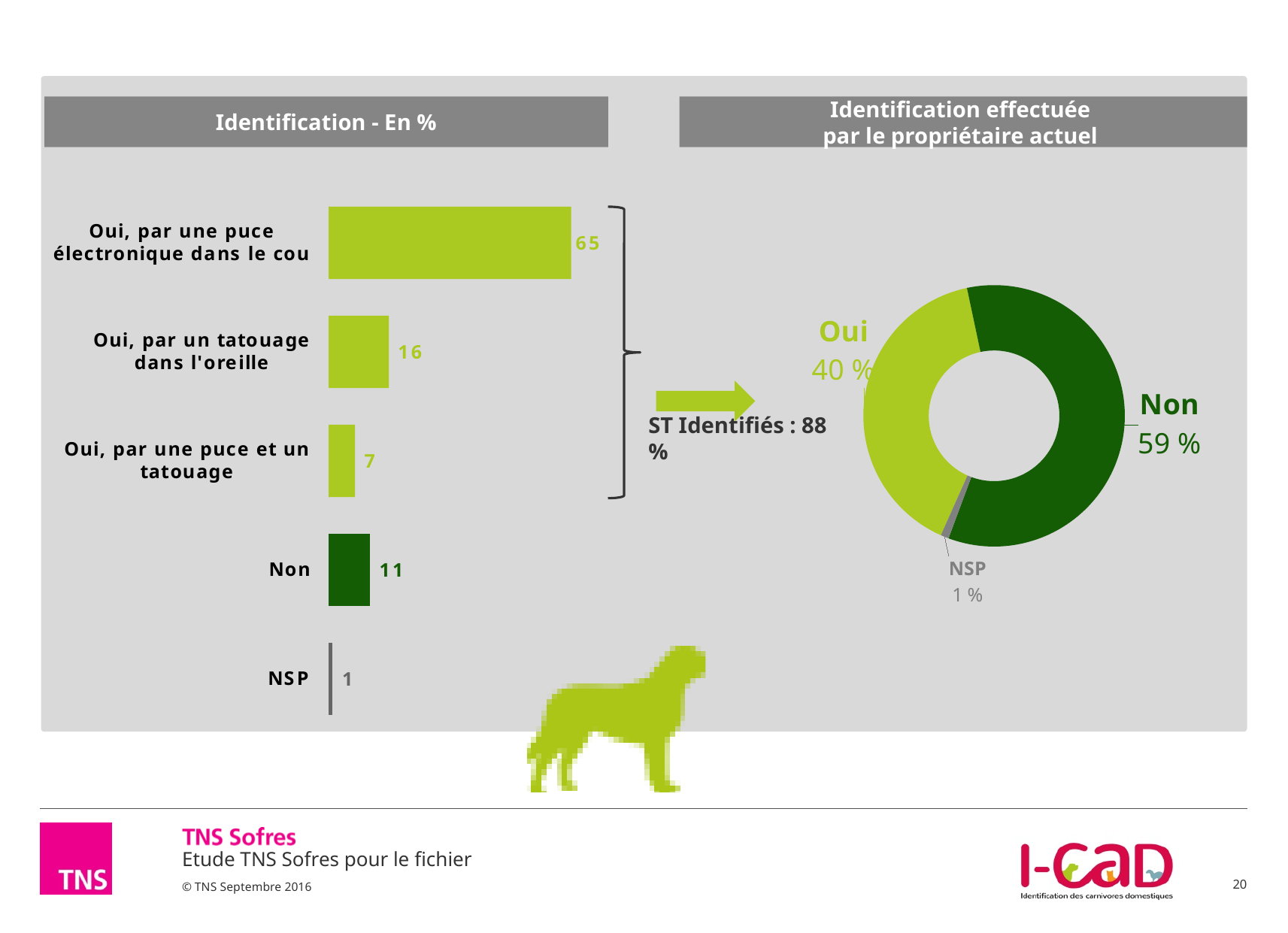
How many categories does the 'Identification - En %' chart show? 5 In the 'Identification - En %' chart, what is the value for 'Non'? 11 In the 'Identification effectuée par le propriétaire actuel' chart, what share is 'Oui'? 40 % In the 'Identification - En %' chart, which category has the lowest value? NSP In the 'Identification - En %' chart, what is the value for 'Oui, par une puce électronique dans le cou'? 65 In the 'Identification - En %' chart, which is larger: 'Non' or 'Oui, par une puce et un tatouage'? Non What kind of chart is 'Identification - En %'? Bar chart In the 'Identification - En %' chart, what is the value for 'Oui, par un tatouage dans l'oreille'? 16 What is the 'ST Identifiés' total shown next to the 'Identification - En %' chart? 88 % In the 'Identification effectuée par le propriétaire actuel' chart, what share is 'Non'? 59 % In the 'Identification - En %' chart, which category has the highest value? Oui, par une puce électronique dans le cou In the 'Identification - En %' chart, what is the difference between 'Oui, par une puce électronique dans le cou' and 'Oui, par un tatouage dans l'oreille'? 49